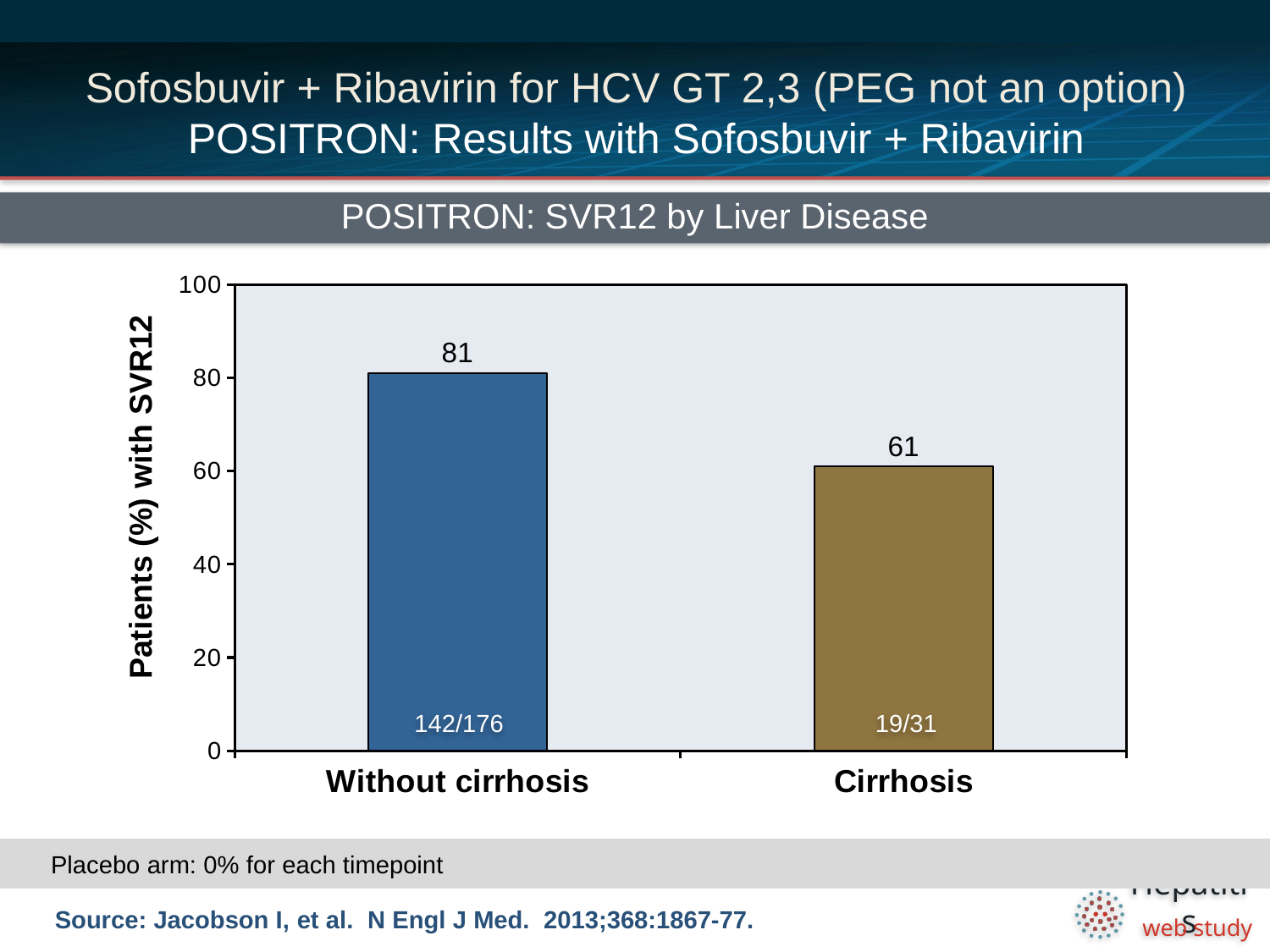
What is the difference in SVR12 rate between the Without cirrhosis and Cirrhosis groups? 20 Which group has the lower SVR12 rate? Cirrhosis What type of chart is shown on the slide? Bar chart What is the SVR12 rate for patients without cirrhosis? 81 What fraction of patients is printed inside the Cirrhosis bar? 19/31 Which group has the higher SVR12 rate? Without cirrhosis What fraction of patients is printed inside the Without cirrhosis bar? 142/176 What is the label on the y-axis of the chart? Patients (%) with SVR12 Is the SVR12 rate for the Cirrhosis group greater or less than 80? less What is the SVR12 rate for patients with cirrhosis? 61 How many patient groups are shown in the chart? 2 What is the title of the chart? POSITRON: SVR12 by Liver Disease